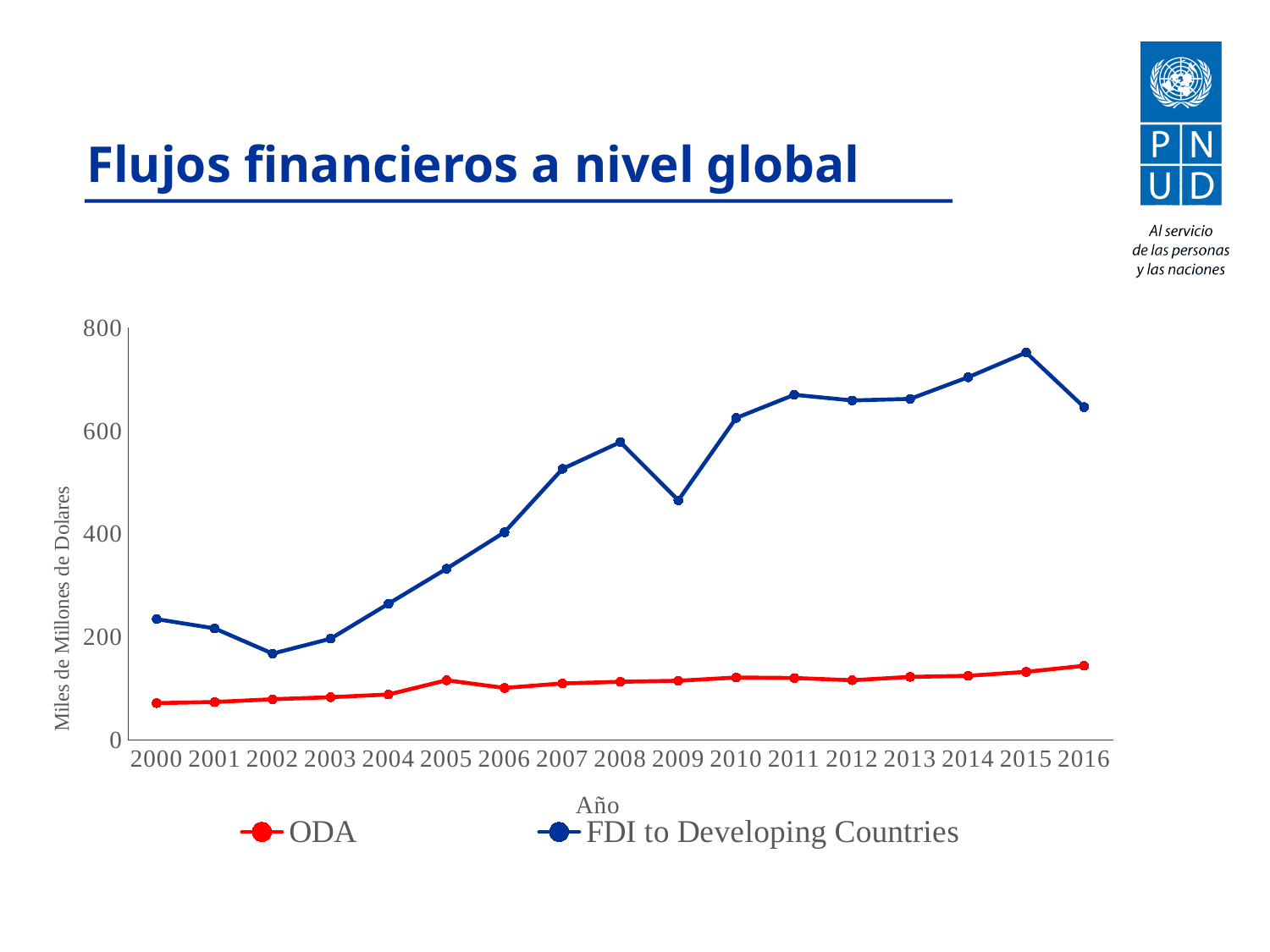
Is the value for FDI to Developing Countries in 2015 greater or less than 600? greater Which is larger for FDI to Developing Countries: the value in 2008 or the value in 2009? 2008 How many series does the legend list? 2 Is the value for ODA in 2016 greater or less than 200? less How many years are plotted along the x axis? 17 Does the value for ODA generally rise or fall from 2000 to 2016? Rise Is the value for FDI to Developing Countries in 2002 greater or less than 200? less What kind of chart is shown on the slide? Line chart What is the label on the y axis? Miles de Millones de Dolares In which year is the value for ODA highest? 2016 In which year is the value for FDI to Developing Countries lowest? 2002 In which year is the value for FDI to Developing Countries highest? 2015